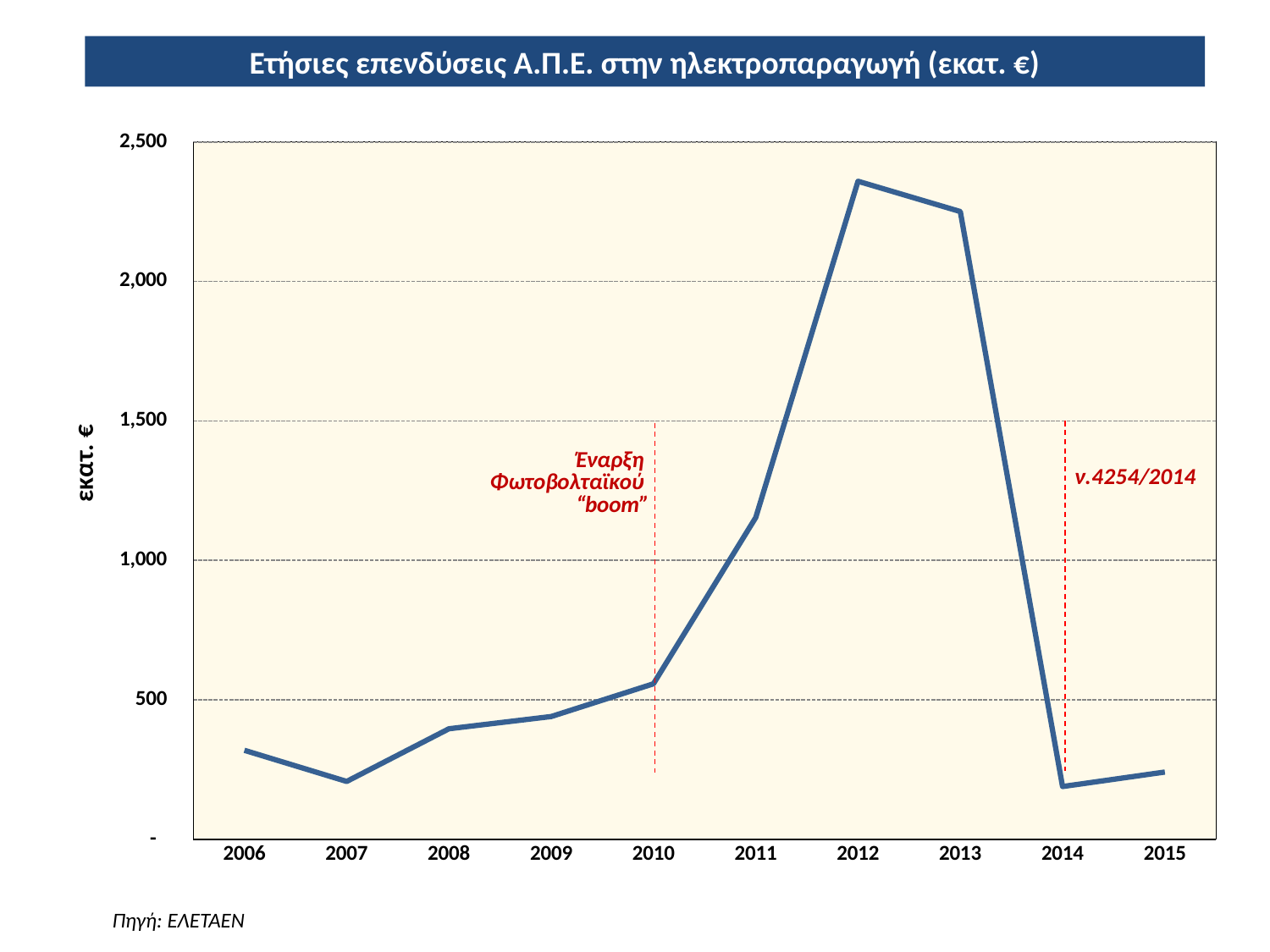
Is the value for 2012 greater or less than 2,000? greater Is the value for 2011 greater or less than 1,000? greater Which year has the larger value, 2012 or 2013? 2012 Do the values rise or fall from 2009 to 2012? rise Which year has the larger value, 2010 or 2011? 2011 What kind of chart is shown on the slide? line chart What is the title of the chart? Ετήσιες επενδύσεις Α.Π.Ε. στην ηλεκτροπαραγωγή (εκατ. €) Do the values rise or fall from 2013 to 2014? fall Is the value for 2014 greater or less than 500? less Which year has the highest annual investment value? 2012 How many years are plotted on the x axis? 10